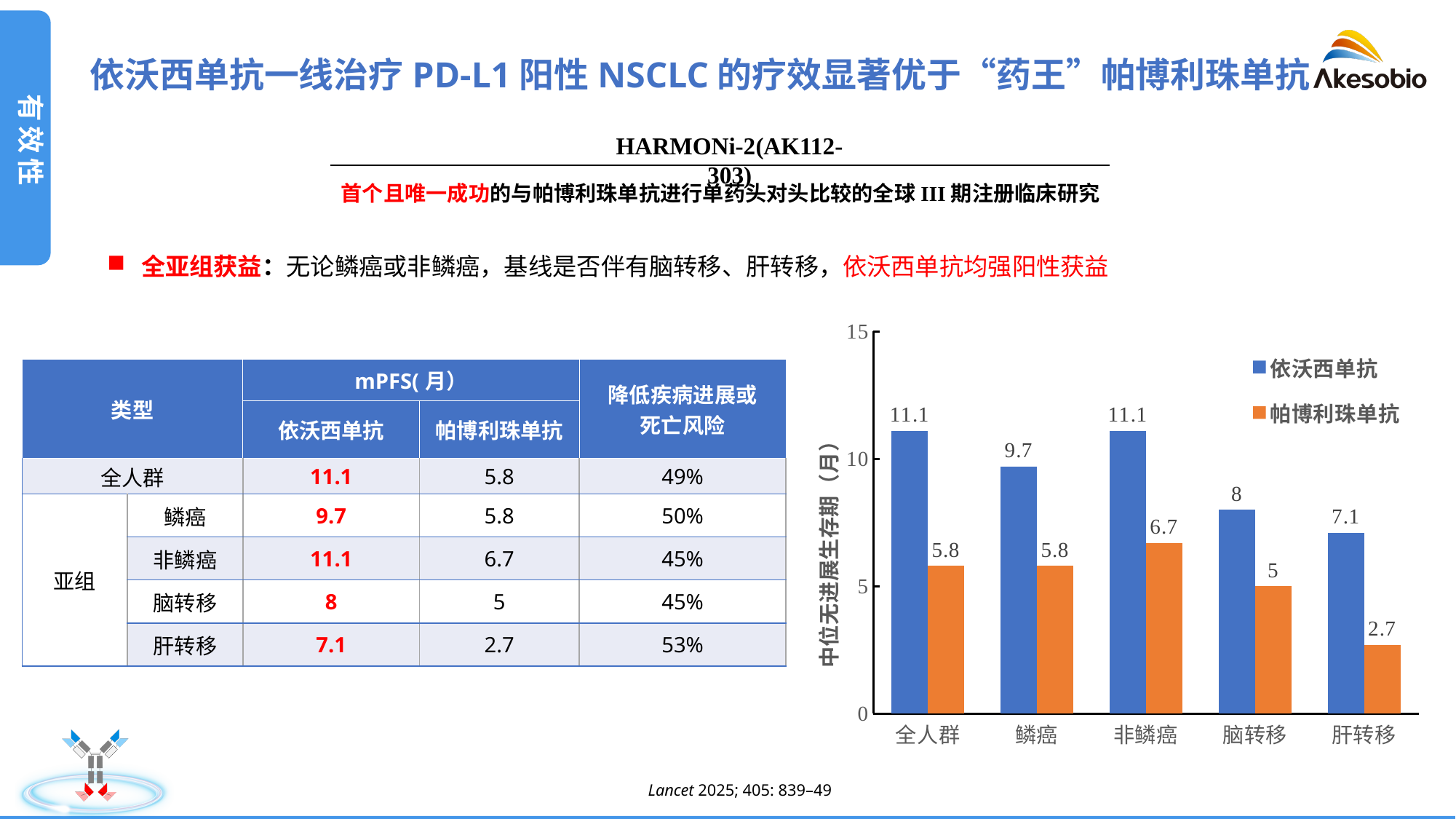
What is the label of the y axis of the chart? 中位无进展生存期（月） In which category is the value for 依沃西单抗 the lowest? 肝转移 In which category is the value for 帕博利珠单抗 the highest? 非鳞癌 How many series does the chart legend list? 2 What type of chart is shown on the slide? Bar chart What is the value for 依沃西单抗 in the 鳞癌 category? 9.7 In which category is the value for 帕博利珠单抗 the lowest? 肝转移 What is the difference between 依沃西单抗 and 帕博利珠单抗 in the 肝转移 category? 4.4 Which is larger in the 全人群 category, 依沃西单抗 or 帕博利珠单抗? 依沃西单抗 What is the value for 依沃西单抗 in the 脑转移 category? 8 How many categories are shown on the x axis of the chart? 5 What is the value for 帕博利珠单抗 in the 非鳞癌 category? 6.7